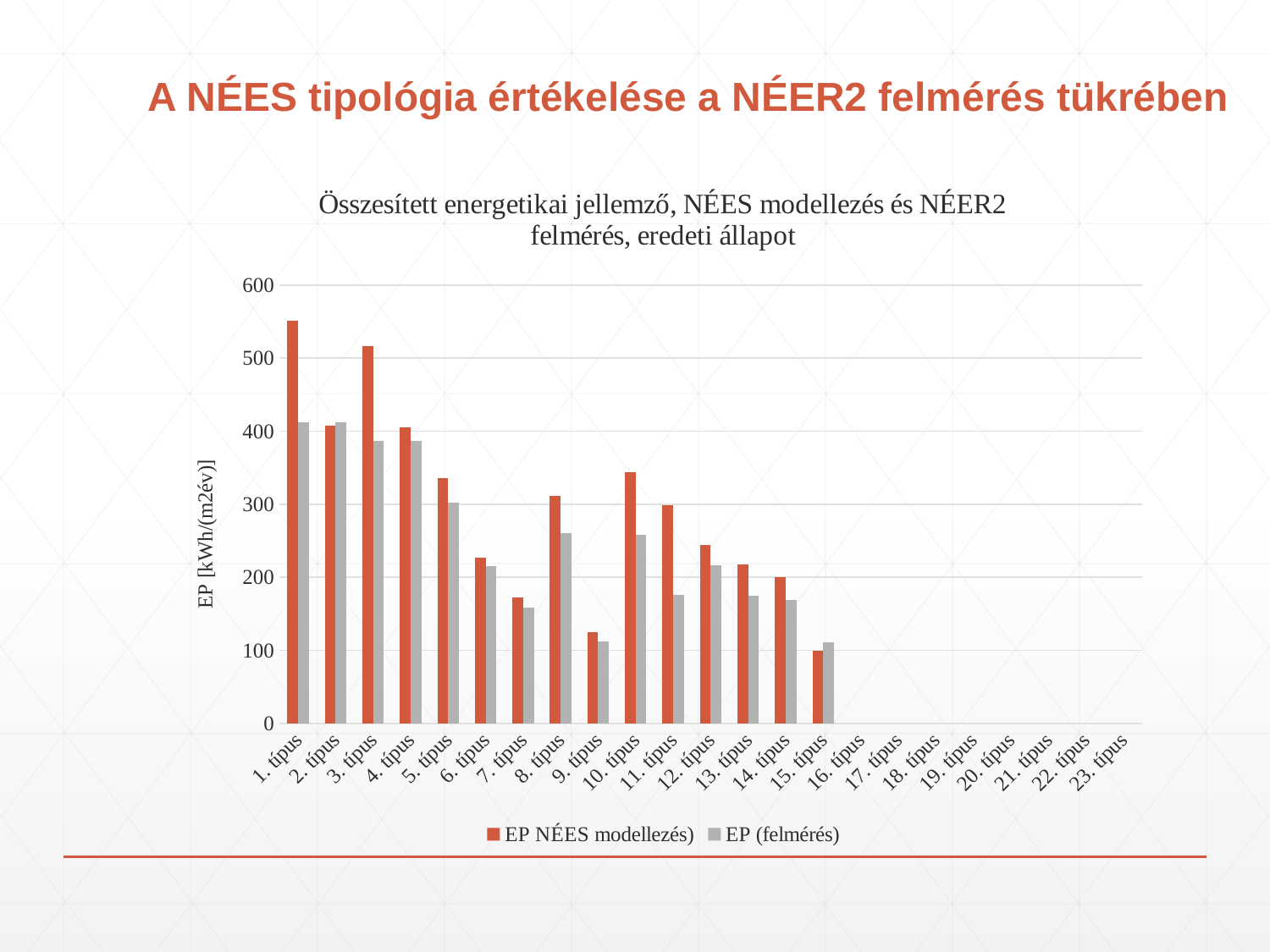
For 1. típus, which is larger: EP NÉES modellezés or EP (felmérés)? EP NÉES modellezés Among the categories with plotted bars, which has the lowest value for EP NÉES modellezés? 15. típus Is the EP (felmérés) value for 15. típus greater or less than 200? less Which category has the highest value for EP NÉES modellezés? 1. típus Is the EP NÉES modellezés value for 5. típus greater or less than 300? greater How many series does the legend list? 2 Is the EP (felmérés) value for 11. típus greater or less than 200? less What is the label of the y axis? EP [kWh/(m2év)] How many categories are labelled on the x axis? 23 What kind of chart is shown on the slide? bar chart For 15. típus, which is larger: EP NÉES modellezés or EP (felmérés)? EP (felmérés)